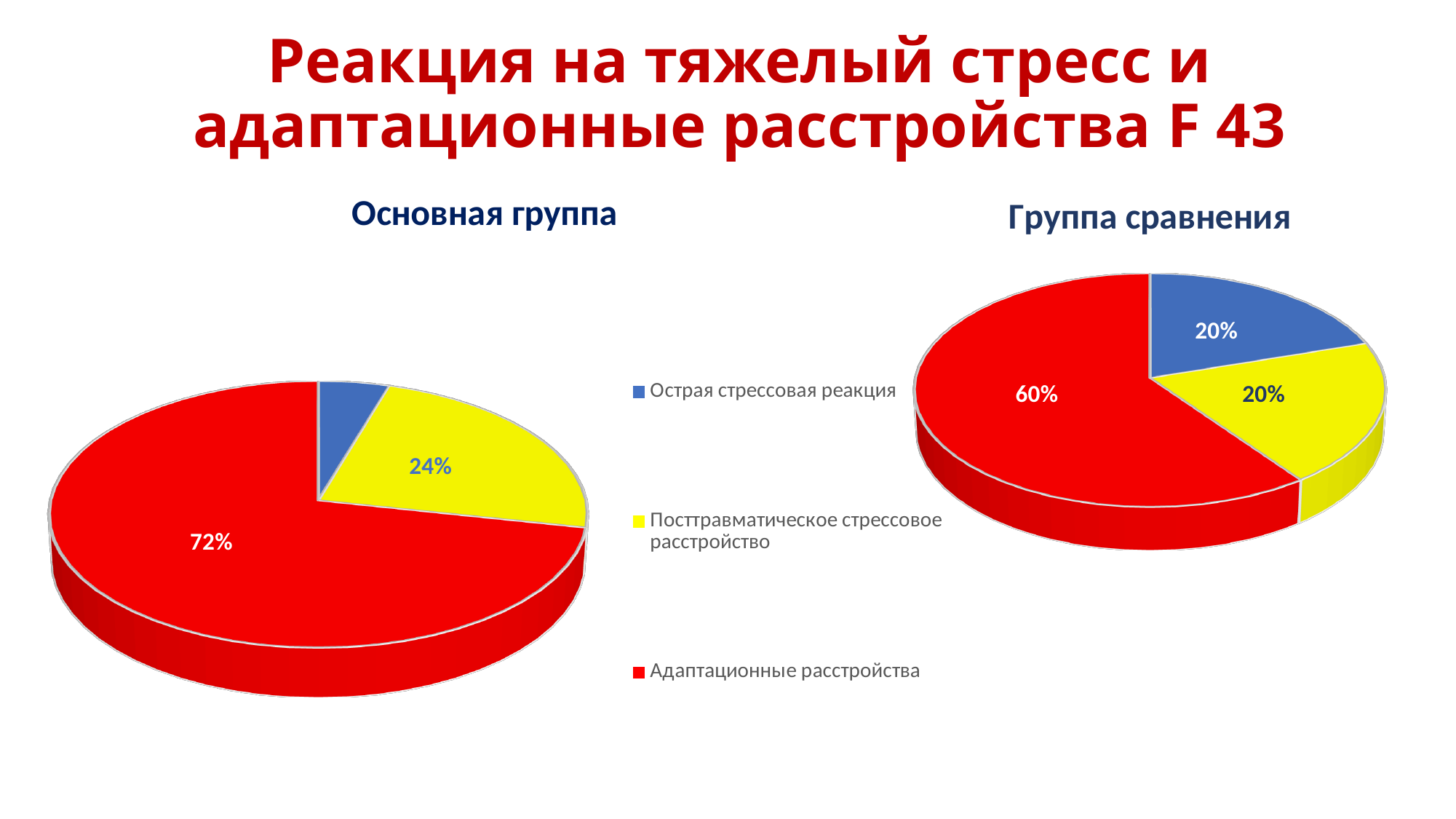
In the 'Группа сравнения' pie chart, what share is shown for Острая стрессовая реакция? 20% In the 'Группа сравнения' pie chart, what share is shown for Посттравматическое стрессовое расстройство? 20% In the 'Основная группа' pie chart, what share is shown for Посттравматическое стрессовое расстройство? 24% In the 'Группа сравнения' pie chart, what share is shown for Адаптационные расстройства? 60% In the 'Основная группа' pie chart, what share is shown for Адаптационные расстройства? 72% In the 'Основная группа' pie chart, which category has the smallest slice? Острая стрессовая реакция How many categories does the legend list? 3 In the 'Группа сравнения' pie chart, which category has the largest slice? Адаптационные расстройства In the 'Основная группа' pie chart, what is the difference in percentage points between Адаптационные расстройства and Посттравматическое стрессовое расстройство? 48 percentage points In the 'Основная группа' pie chart, which category has the largest slice? Адаптационные расстройства Which chart shows a larger share for Адаптационные расстройства, 'Основная группа' or 'Группа сравнения'? Основная группа What type of chart is used for 'Группа сравнения'? Pie chart